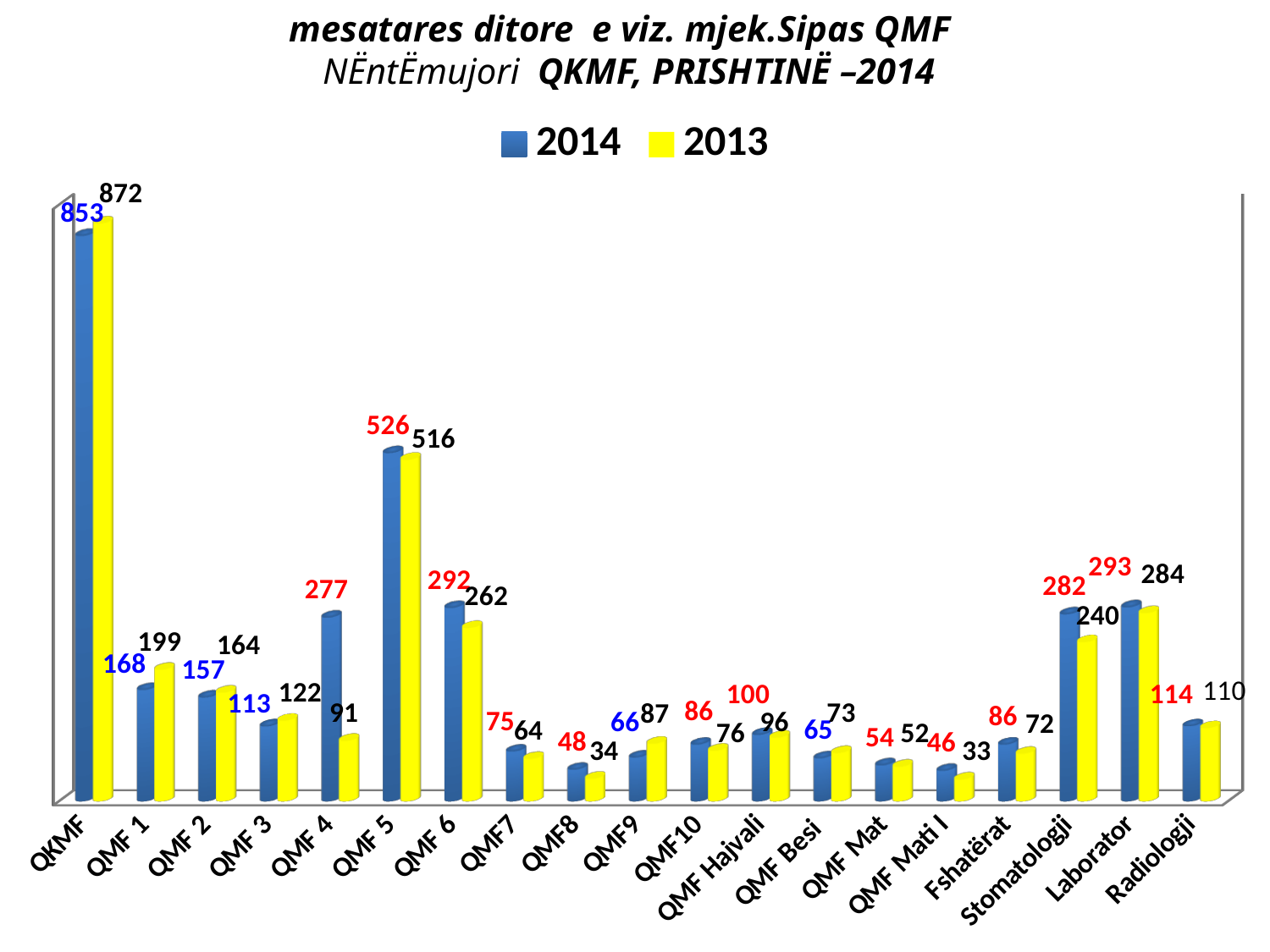
What is the 2013 value for QMF 4? 91 Which is larger for Laborator, the 2014 value or the 2013 value? 2014 How many series does the legend list? 2 What is the difference between the 2014 and 2013 values for QMF 4? 186 What kind of chart is shown on the slide? Bar chart What is the 2014 value for QMF 5? 526 Which category has the highest 2014 value? QKMF How many categories are shown on the x axis? 19 Which is larger for QMF9, the 2014 value or the 2013 value? 2013 What is the 2014 value for Stomatologji? 282 What is the difference between the 2013 and 2014 values for QKMF? 19 Which category has the lowest 2013 value? QMF Mati I